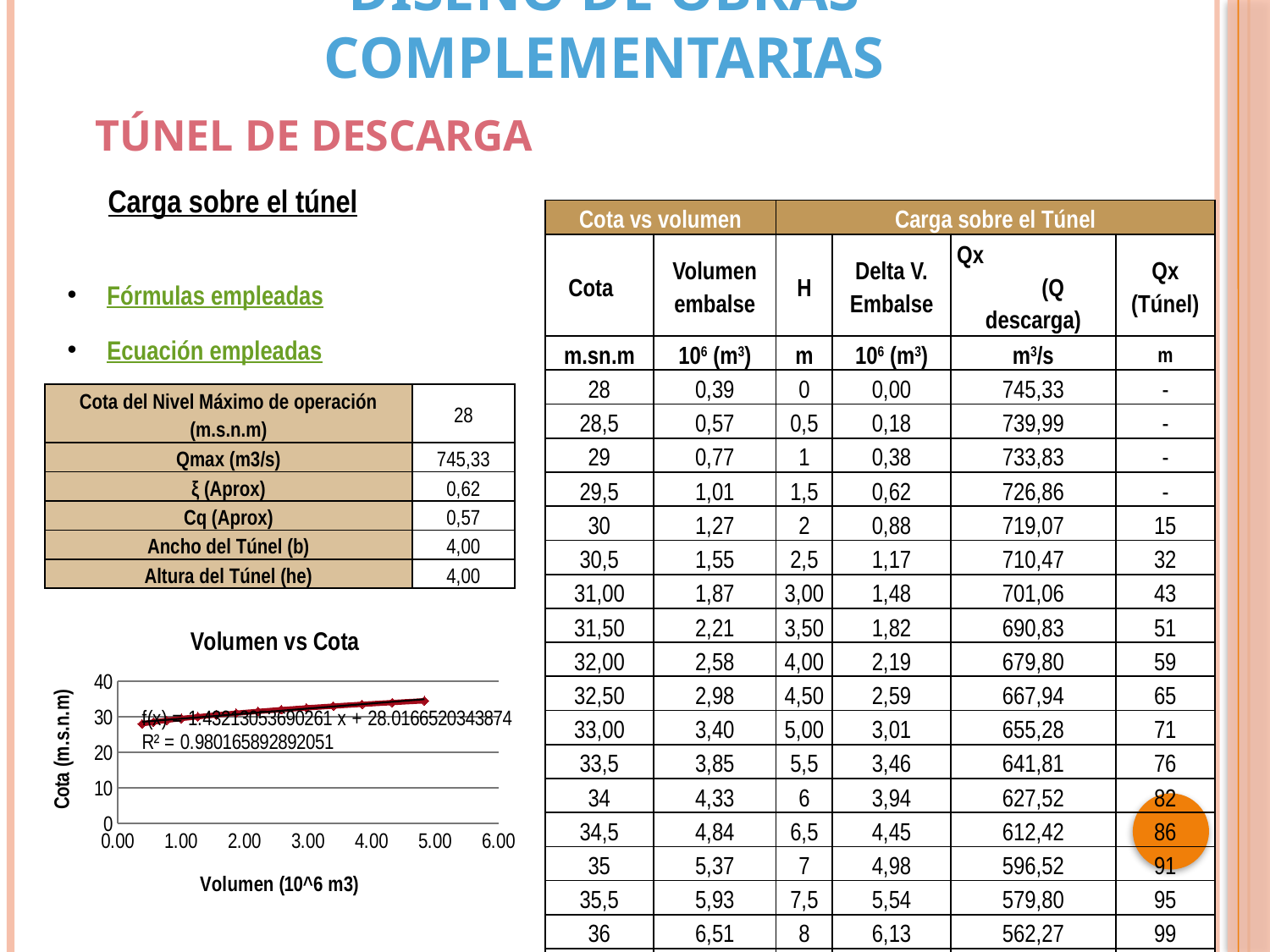
What is the label of the x axis of the "Volumen vs Cota" chart? Volumen (10^6 m3) In the "Volumen vs Cota" chart, do the Cota values rise or fall as Volumen increases along the x axis? rise In the "Volumen vs Cota" chart, is the Cota value of the rightmost plotted point greater or less than 30? greater What is the slope of the trendline equation printed on the "Volumen vs Cota" chart? 1.43213053690261 What is the intercept of the trendline equation printed on the "Volumen vs Cota" chart? 28.0166520343874 In the "Volumen vs Cota" chart, is the Cota value of the leftmost plotted point greater or less than 20? greater What R² value is printed on the "Volumen vs Cota" chart? 0.980165892892051 What is the highest tick value shown on the x axis of the "Volumen vs Cota" chart? 6.00 In the "Volumen vs Cota" chart, is the Cota value of the rightmost plotted point greater or less than 40? less What is the highest tick value shown on the y axis of the "Volumen vs Cota" chart? 40 What is the title of the chart on the slide? Volumen vs Cota What kind of chart is the "Volumen vs Cota" chart? scatter chart with a trendline